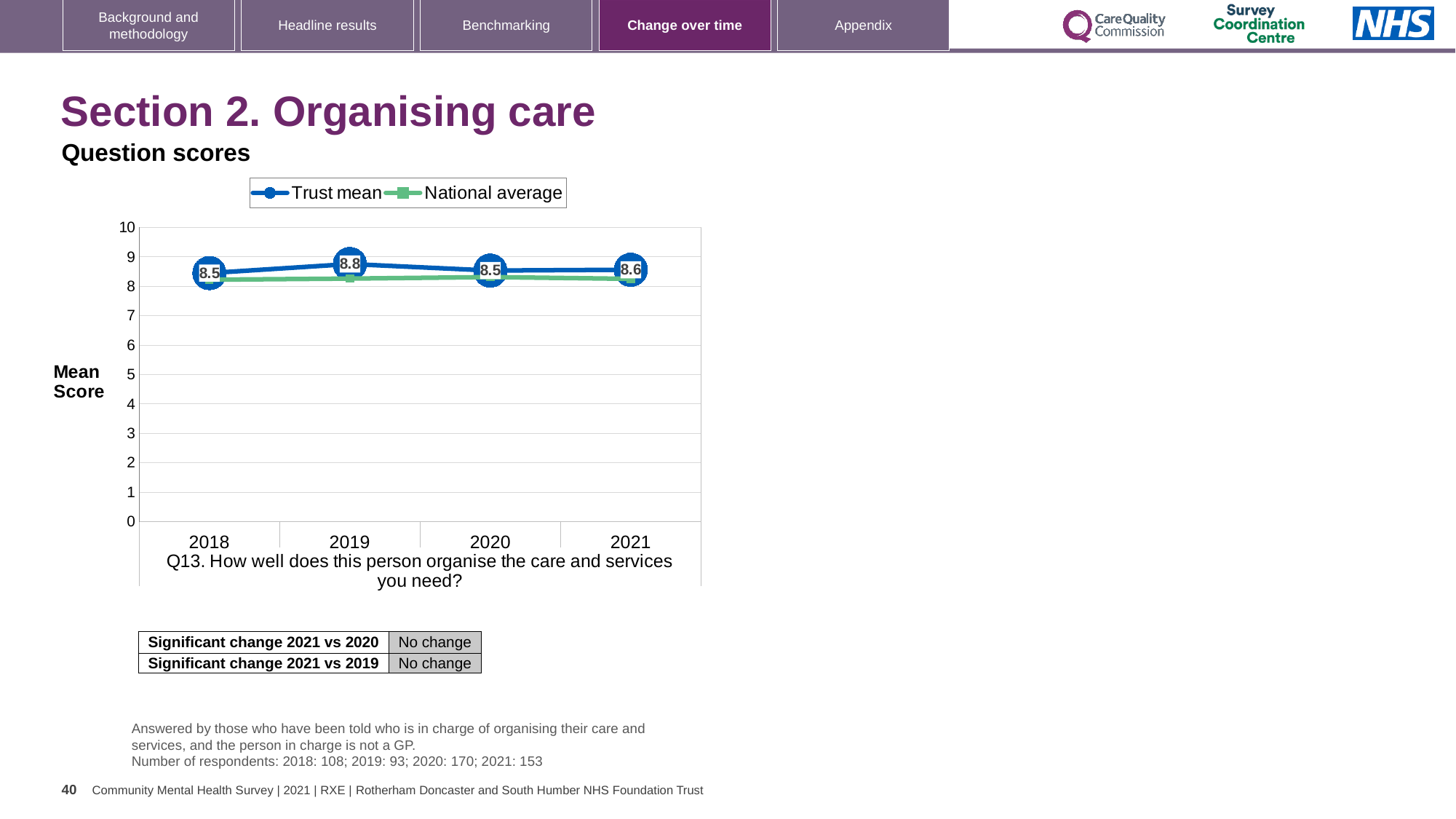
What is the difference between the Trust mean score in 2019 and in 2018? 0.3 How many years are plotted on the x axis? 4 What is the Trust mean score for 2021? 8.6 What is the Trust mean score for 2019? 8.8 What is the label on the y axis of the chart? Mean Score In which year is the Trust mean score highest? 2019 How many series does the legend list? 2 Which is larger, the Trust mean score for 2019 or for 2021? 2019 Is the National average value for 2018 greater or less than 5? greater What kind of chart is shown on the slide? line chart Does the Trust mean score rise or fall from 2018 to 2019? rise What is the Trust mean score for 2018? 8.5